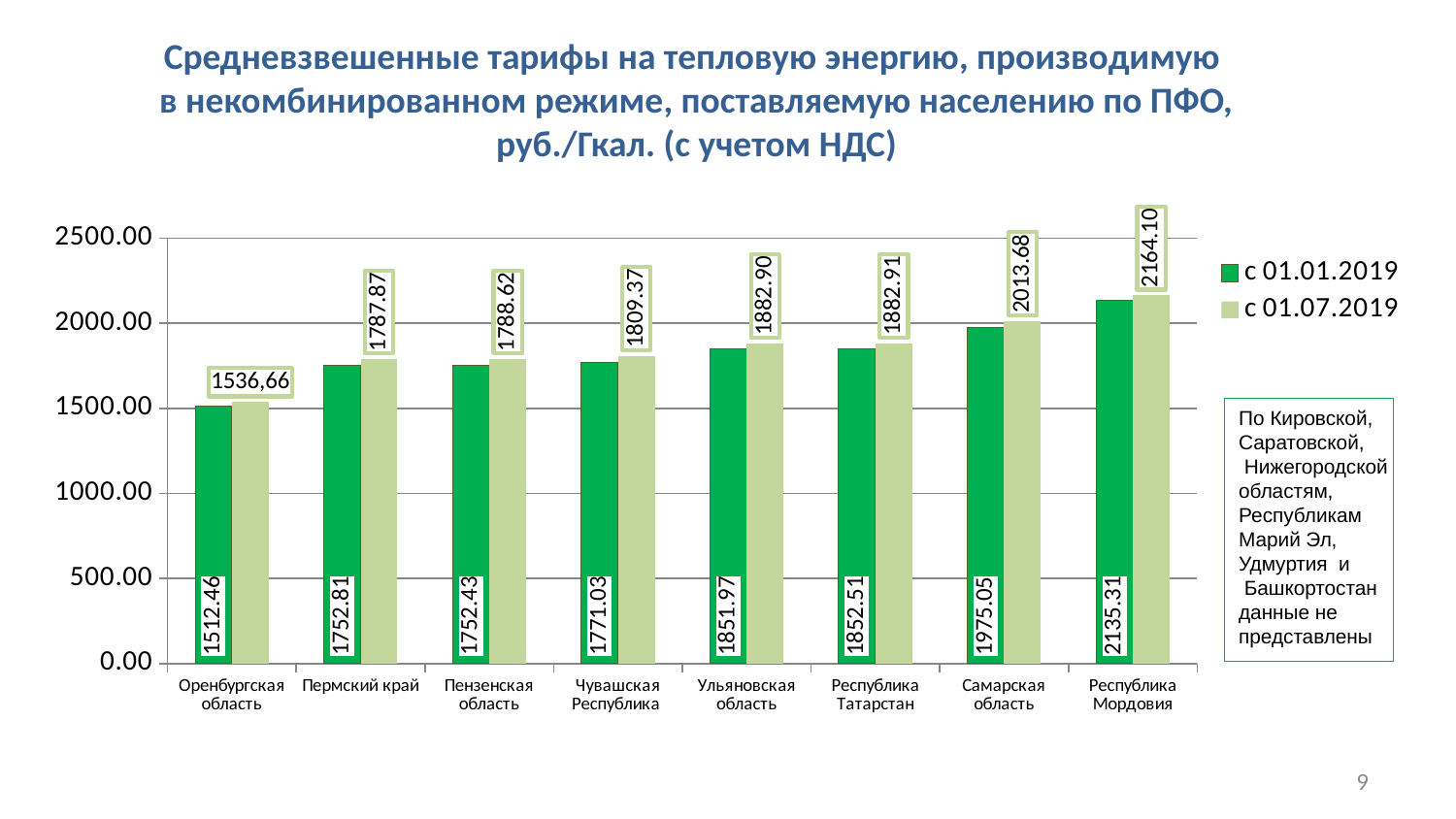
Which is larger in the series с 01.01.2019: Самарская область or Республика Татарстан? Самарская область How many series does the legend list? 2 What is the value for Чувашская Республика in the series с 01.01.2019? 1771.03 Is the value for Оренбургская область in the series с 01.07.2019 greater or less than 2000? less What is the value for Самарская область in the series с 01.07.2019? 2013.68 Which region has the lowest value in the series с 01.07.2019? Оренбургская область Which region has the highest value in the series с 01.01.2019? Республика Мордовия What type of chart is shown on the slide? bar chart How many regions are shown on the x axis? 8 What is the value for Республика Мордовия in the series с 01.07.2019? 2164.10 What is the difference between the с 01.07.2019 and с 01.01.2019 values for Республика Мордовия? 28.79 What is the value for Оренбургская область in the series с 01.01.2019? 1512.46